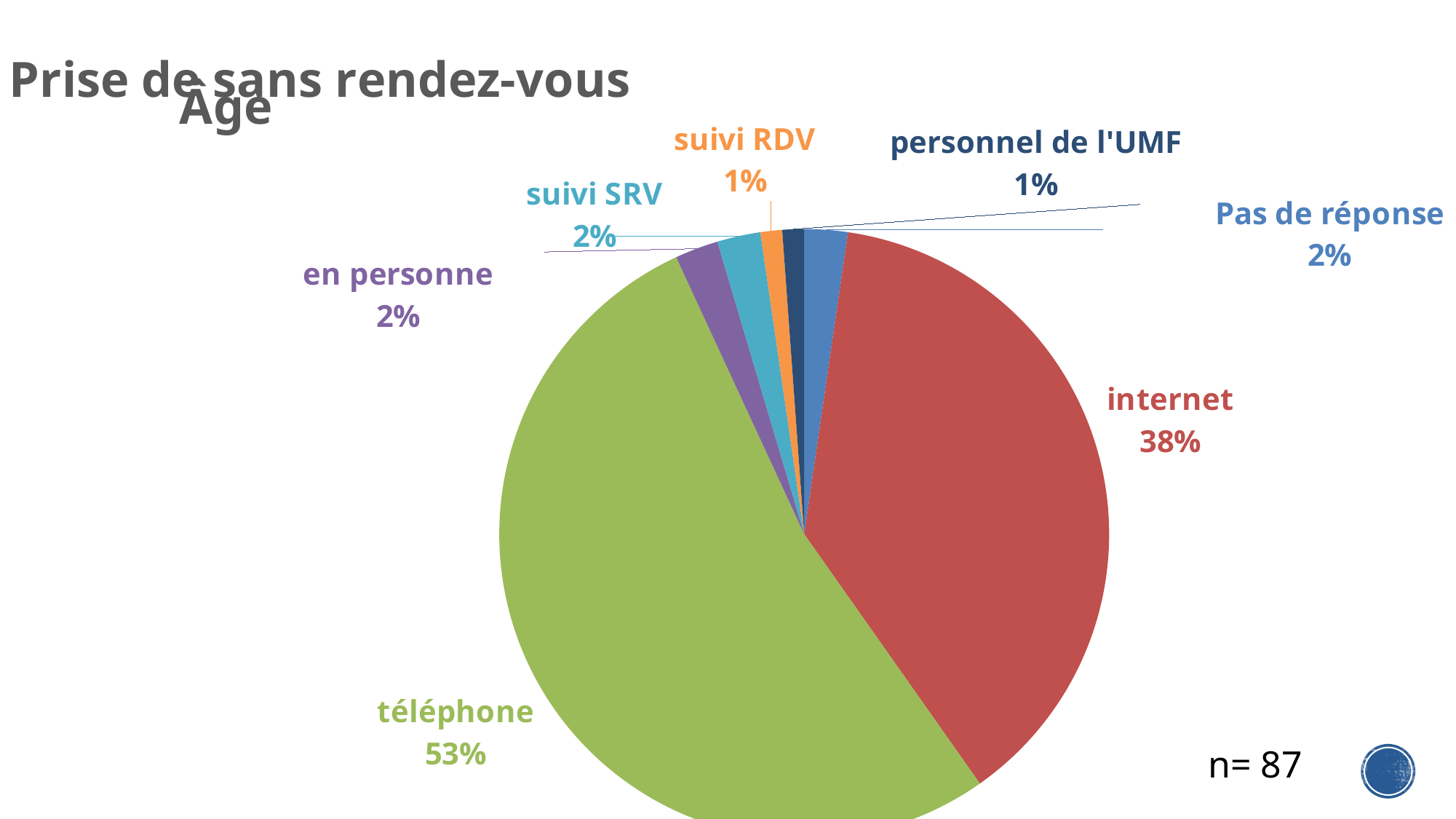
Which is larger, the share for internet or the share for téléphone? téléphone Which category has the largest slice of the pie? téléphone What is the difference between the téléphone and internet shares? 15% What share of the pie does téléphone represent? 53% What sample size (n) is shown on the slide? n= 87 What kind of chart is shown on the slide? pie chart What is the value shown for Pas de réponse? 2% What is the value shown for personnel de l'UMF? 1% What share of the pie does internet represent? 38% How many slices does the pie chart have? 7 What is the value shown for en personne? 2% What is the value shown for suivi SRV? 2%